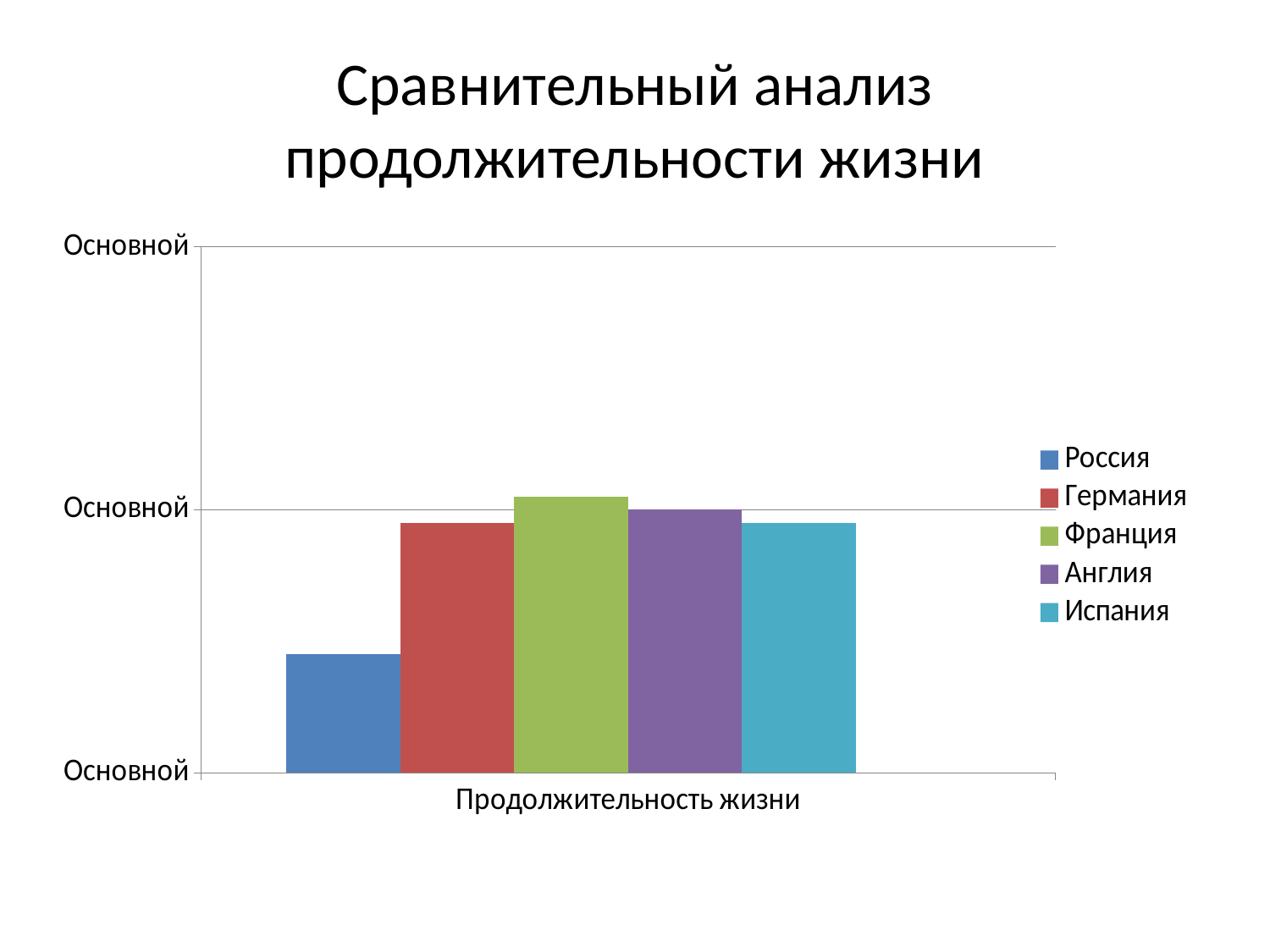
Which series has the highest bar? Франция Which is larger, the bar for Франция or the bar for Россия? Франция Which is larger, the bar for Россия or the bar for Германия? Германия Which is larger, the bar for Испания or the bar for Россия? Испания What kind of chart is shown on the slide? bar chart Which series has the lowest bar? Россия What is the label of the category on the x axis? Продолжительность жизни What is the title of the chart on the slide? Сравнительный анализ продолжительности жизни How many categories are shown on the x axis? 1 How many series does the legend list? 5